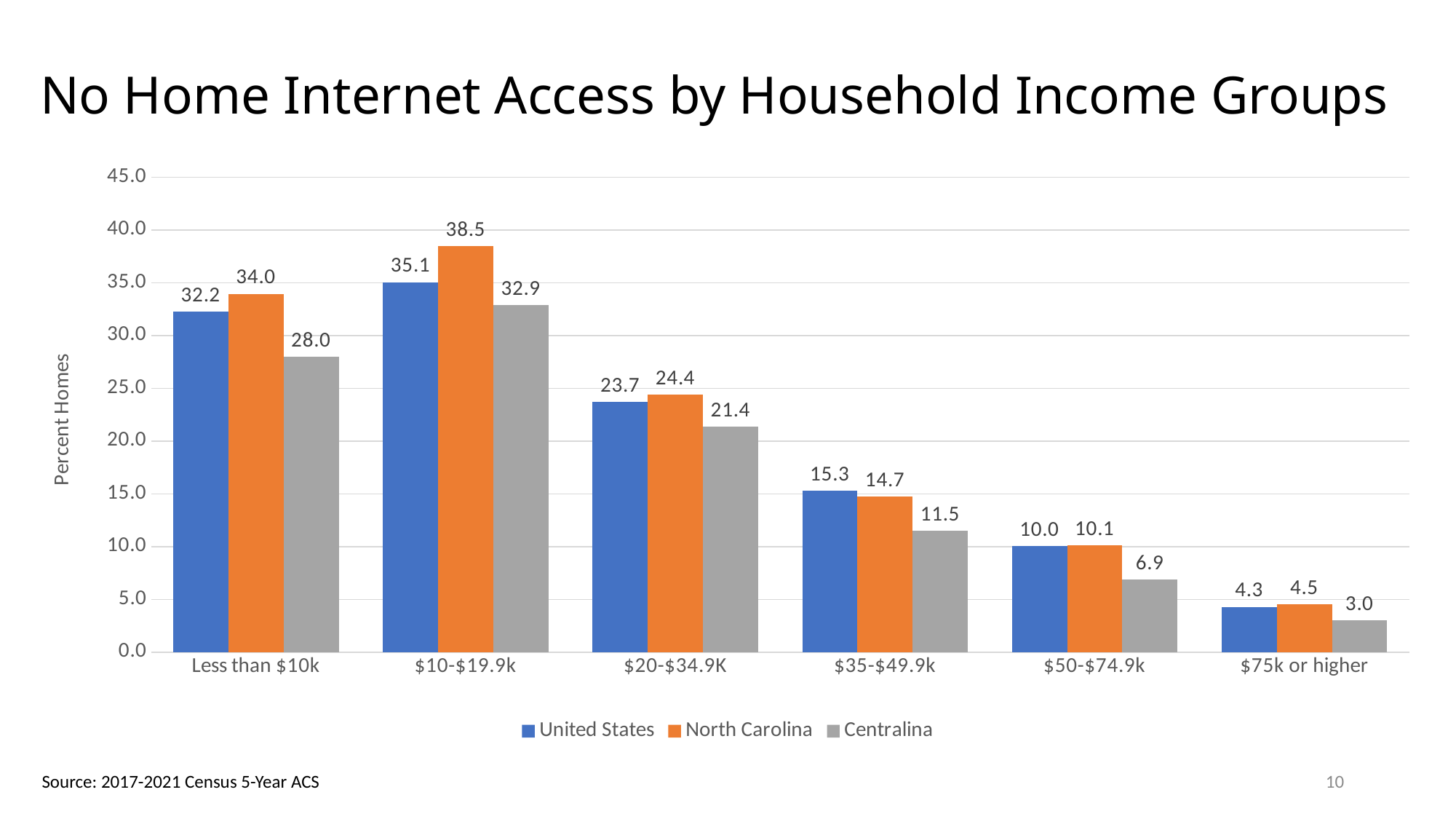
Which income group has the lowest value for Centralina? $75k or higher Which income group has the highest value for North Carolina? $10-$19.9k What kind of chart is shown on the slide? bar chart What is the value for North Carolina in the $10-$19.9k income group? 38.5 How many series does the legend list? 3 How many income groups are shown on the x axis? 6 What is the value for the United States in the $75k or higher income group? 4.3 Do the Centralina values rise or fall as household income increases along the x axis? fall (after rising from the first to the second group) What is the value for Centralina in the $35-$49.9k income group? 11.5 What is the difference between the North Carolina and Centralina values in the $10-$19.9k income group? 5.6 Is the value for Centralina in the $20-$34.9K income group greater or less than 25.0? less In the $35-$49.9k income group, which is larger: the United States value or the North Carolina value? United States